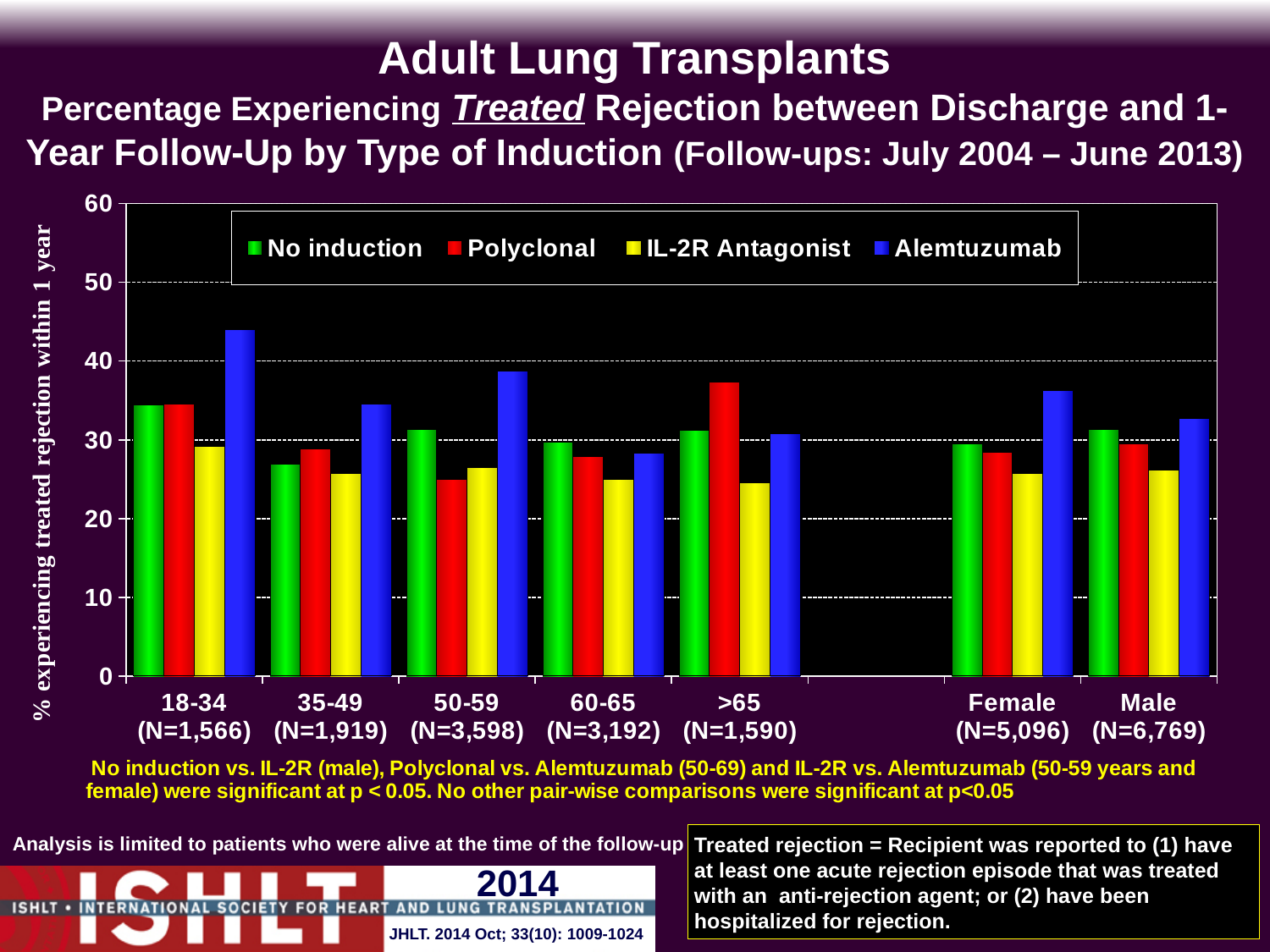
Which induction type has the highest value in the 18-34 age group? Alemtuzumab How many categories are shown along the x axis? 7 Which is larger: the Alemtuzumab value for the 18-34 age group or the Alemtuzumab value for the 60-65 age group? 18-34 What kind of chart is shown on the slide? bar chart What colour represents Alemtuzumab in the legend? blue Is the value for IL-2R Antagonist in the >65 age group greater or less than 30? less Is the value for Polyclonal in the 50-59 age group greater or less than 30? less Is the value for Alemtuzumab in the 18-34 age group greater or less than 40? greater Which induction type has the lowest value in the >65 age group? IL-2R Antagonist Which induction type has the highest value in the >65 age group? Polyclonal How many series does the legend list? 4